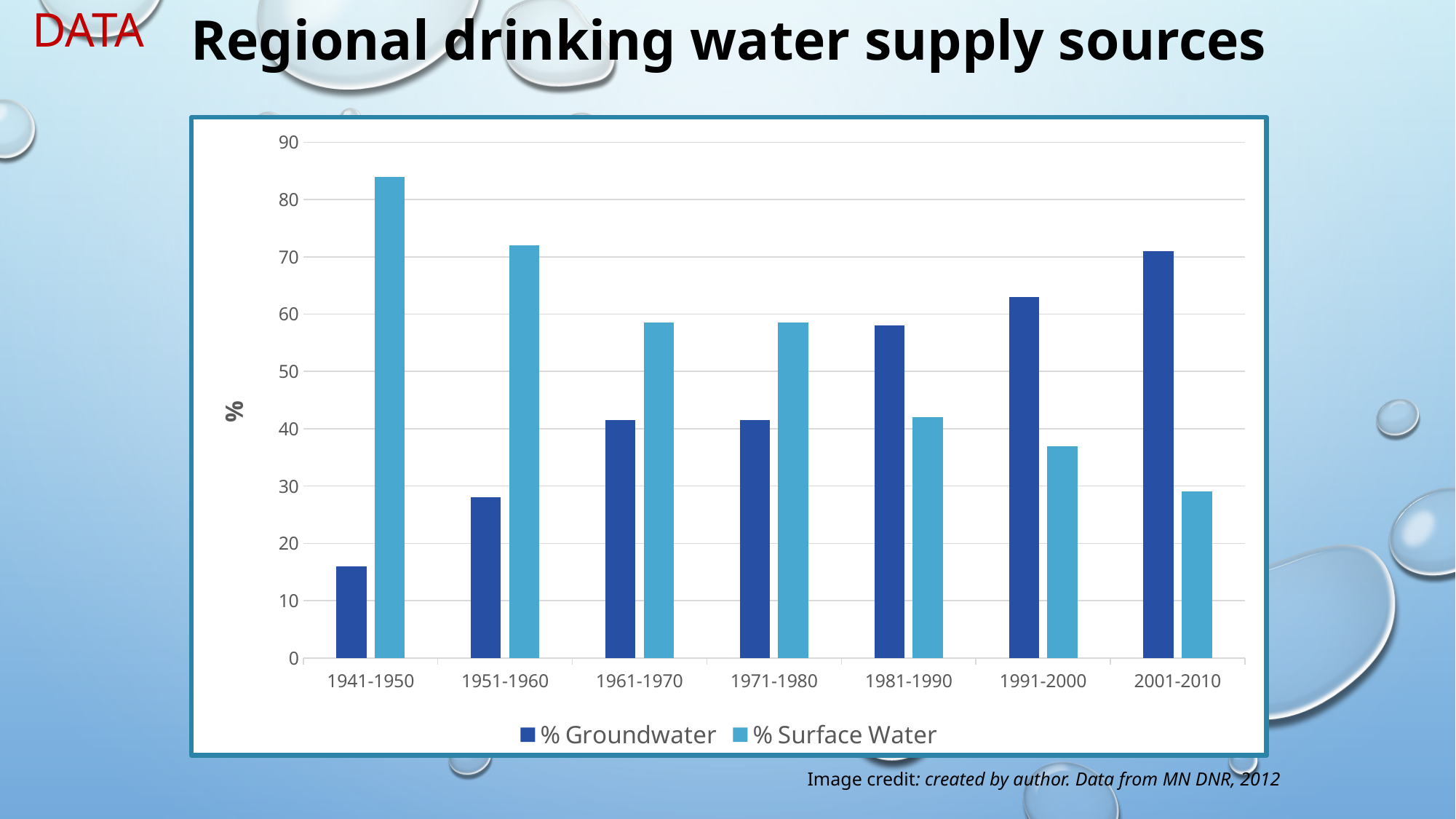
Is the % Groundwater value for 1941-1950 greater or less than 20? less What kind of chart is shown on the slide? bar chart In 1981-1990, which is larger: % Groundwater or % Surface Water? % Groundwater Is the % Surface Water value for 1941-1950 greater or less than 80? greater Which decade has the lowest % Surface Water value? 2001-2010 How many decade categories are shown on the x axis? 7 How many series does the legend list? 2 What is the label on the vertical axis? % Does the % Groundwater series rise or fall across the decades from 1941-1950 to 2001-2010? rise Which decade has the highest % Surface Water value? 1941-1950 Which decade has the highest % Groundwater value? 2001-2010 Which decade has the lowest % Groundwater value? 1941-1950